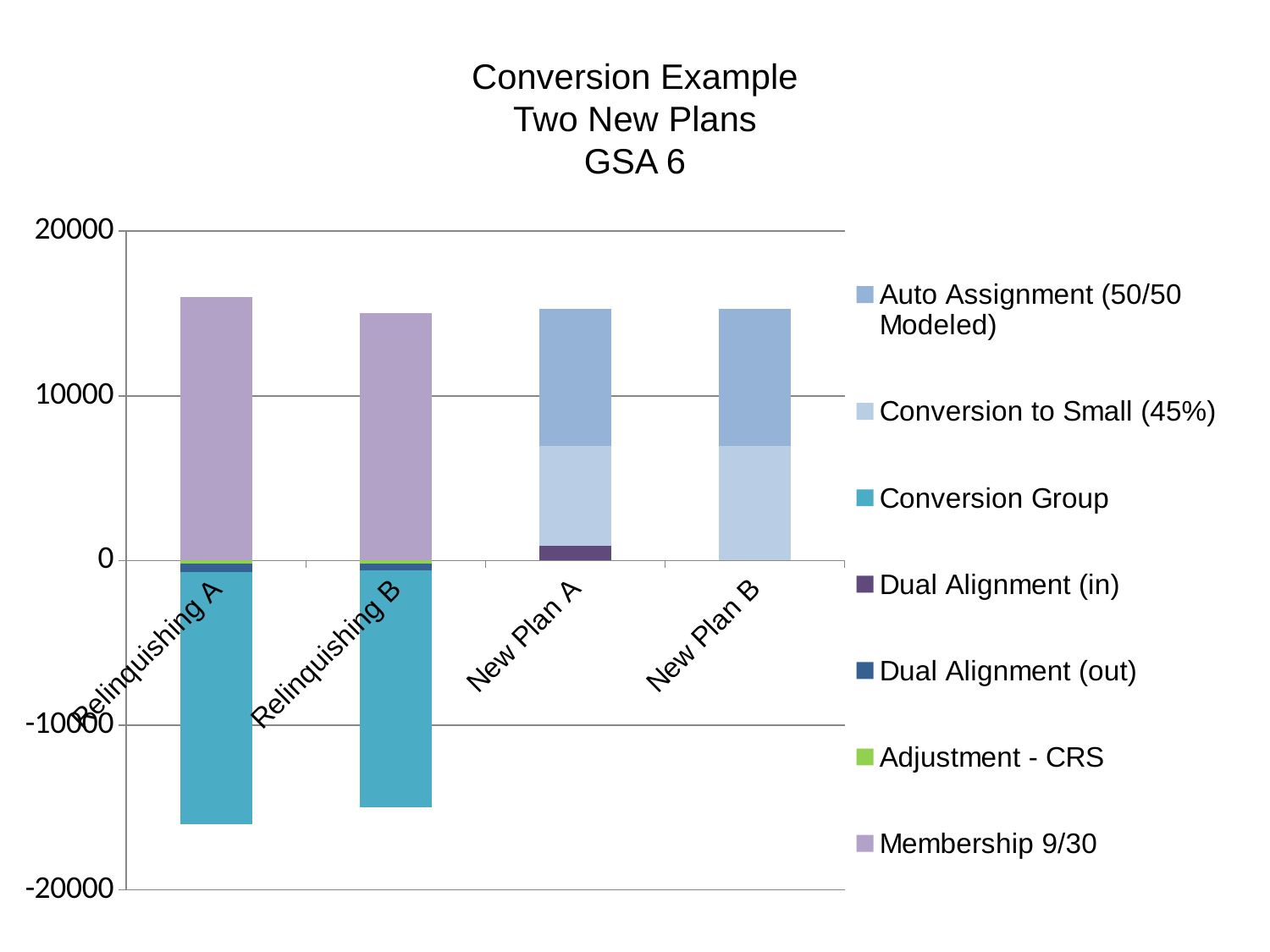
How many categories are shown along the x axis? 4 What kind of chart is shown on the slide? stacked bar chart Is the Conversion Group value for Relinquishing B greater or less than -10000? less How many series does the legend list? 7 Which two categories have negative Conversion Group values? Relinquishing A and Relinquishing B Is the Auto Assignment (50/50 Modeled) value for New Plan A greater or less than 10000? less Is the total stacked height of the New Plan B bar greater or less than 10000? greater Which category has the larger Membership 9/30 value, Relinquishing A or Relinquishing B? Relinquishing A Which category is the only one with a Dual Alignment (in) segment? New Plan A Which category has the highest Membership 9/30 value? Relinquishing A